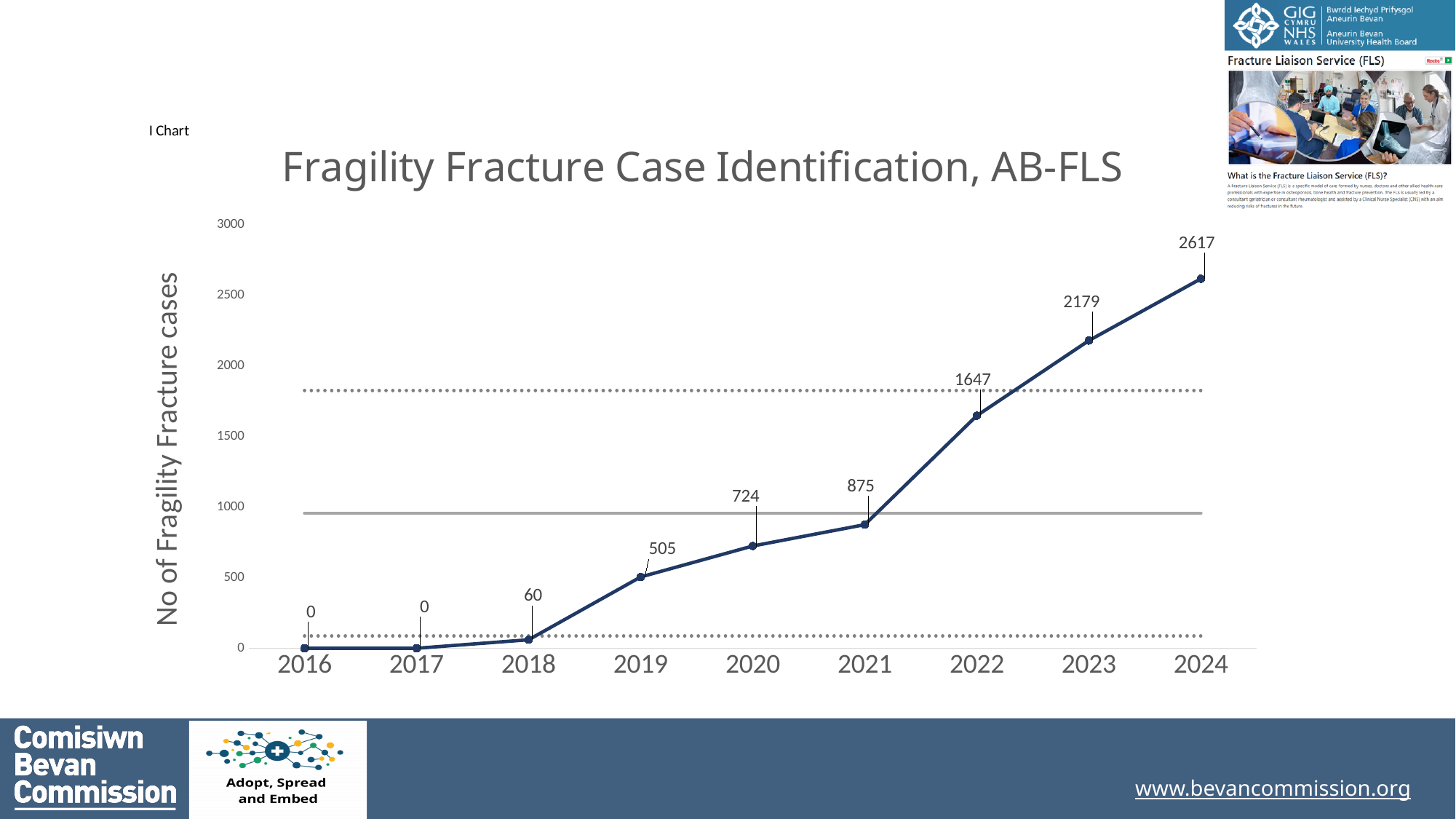
What is the title of the chart? Fragility Fracture Case Identification, AB-FLS What is the number of fragility fracture cases identified in 2019? 505 What is the difference in fragility fracture cases between 2023 and 2022? 532 Do the fragility fracture case numbers rise or fall from 2016 to 2024? Rise What is the number of fragility fracture cases identified in 2022? 1647 Which year has the highest number of fragility fracture cases? 2024 How many years are plotted on the x axis? 9 What kind of chart is shown on the slide? Line chart Which year has more fragility fracture cases, 2020 or 2021? 2021 Is the value for 2022 greater or less than 1500? greater What is the number of fragility fracture cases identified in 2024? 2617 What is the difference in fragility fracture cases between 2021 and 2020? 151